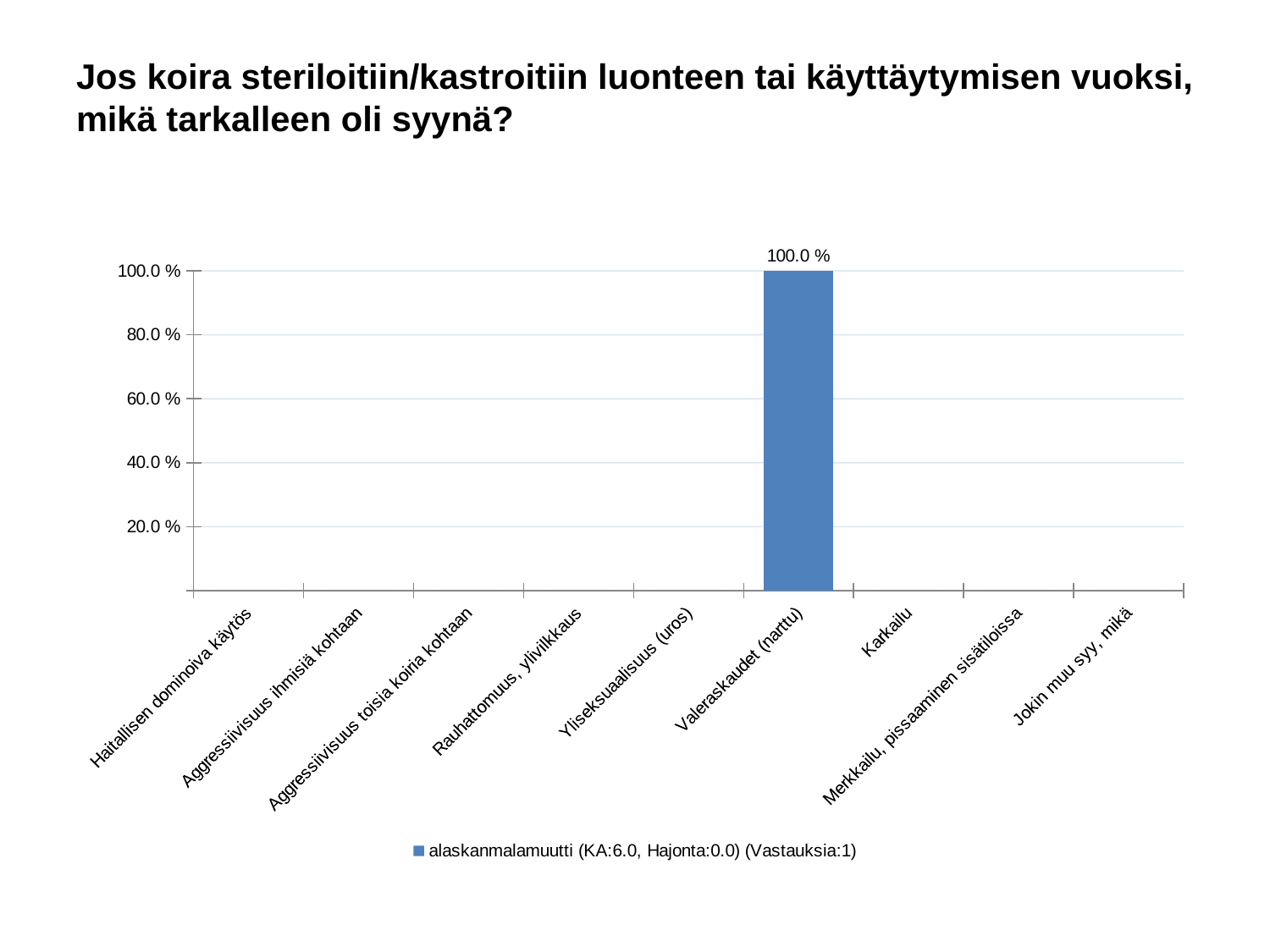
Which category has the highest value? Valeraskaudet (narttu) How many categories have a visible bar in the chart? 1 Is the value for Haitallisen dominoiva käytös greater or less than 20.0 %? less Which is larger, the value for Valeraskaudet (narttu) or the value for Yliseksuaalisuus (uros)? Valeraskaudet (narttu) How many categories are shown on the x axis? 9 What is the value for Valeraskaudet (narttu)? 100.0 % What is the title of the slide? Jos koira steriloitiin/kastroitiin luonteen tai käyttäytymisen vuoksi, mikä tarkalleen oli syynä? What is the series name shown in the legend? alaskanmalamuutti (KA:6.0, Hajonta:0.0) (Vastauksia:1) Is the value for Valeraskaudet (narttu) greater or less than 80.0 %? greater How many series does the legend list? 1 Is the value for Karkailu greater or less than 20.0 %? less What kind of chart is shown on the slide? bar chart